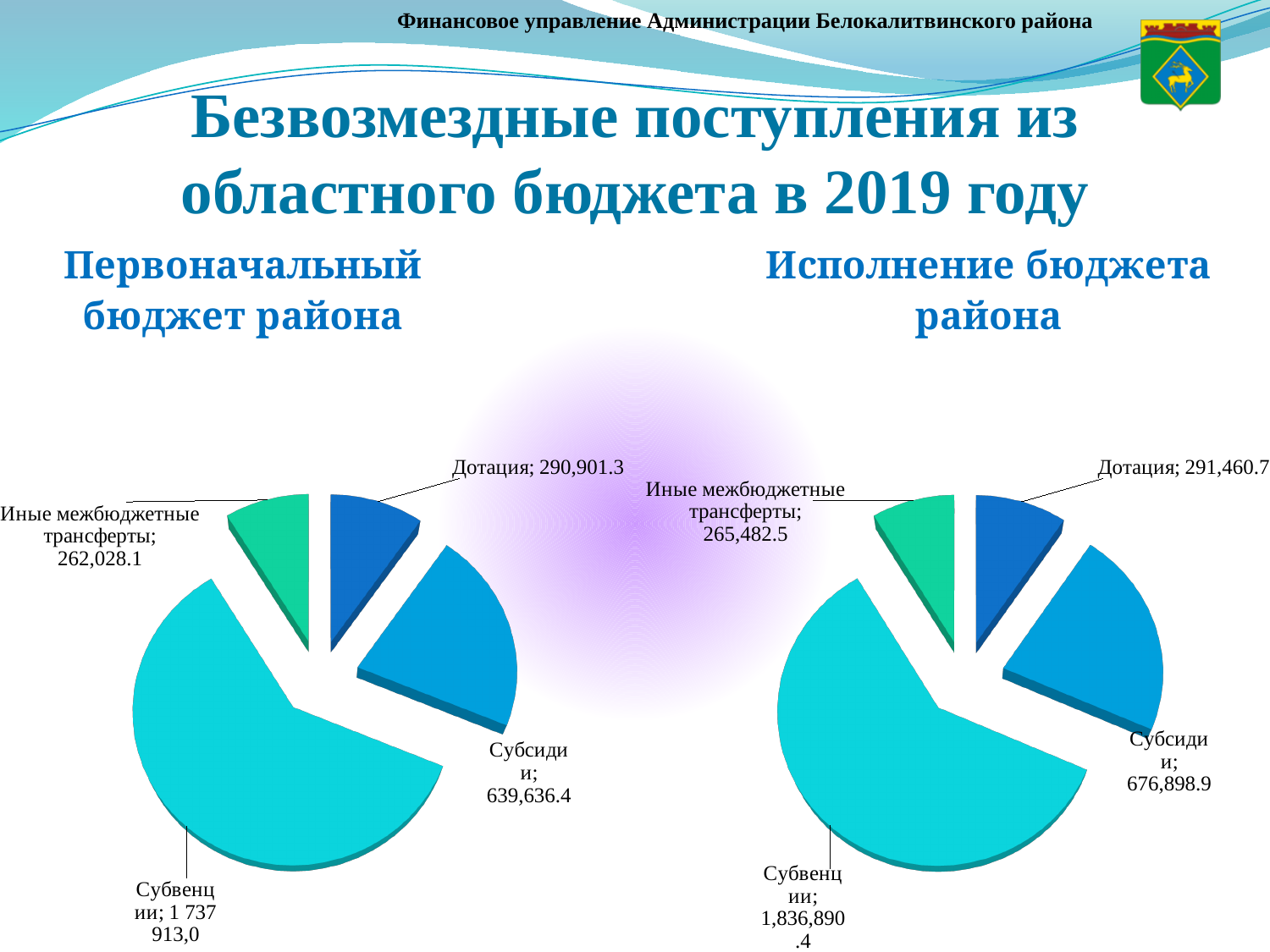
In the 'Исполнение бюджета района' chart, which category has the largest slice? Субвенции What kind of chart is used on the slide for 'Первоначальный бюджет района'? Pie chart In the 'Первоначальный бюджет района' chart, what is the value for Субвенции? 1 737 913,0 In the 'Исполнение бюджета района' chart, what is the value for Дотация? 291,460.7 In the 'Исполнение бюджета района' chart, what is the value for Иные межбюджетные трансферты? 265,482.5 How many pie charts are shown on the slide? 2 In the 'Первоначальный бюджет района' chart, what is the value for Субсидии? 639,636.4 What is the difference between the Субсидии value in the 'Исполнение бюджета района' chart and the Субсидии value in the 'Первоначальный бюджет района' chart? 37,262.5 In the 'Первоначальный бюджет района' chart, which category has the smallest value? Иные межбюджетные трансферты How many slices does the 'Исполнение бюджета района' pie chart have? 4 In the 'Исполнение бюджета района' chart, which is larger: Дотация or Иные межбюджетные трансферты? Дотация In the 'Первоначальный бюджет района' chart, how much larger is Субсидии than Дотация? 348,735.1